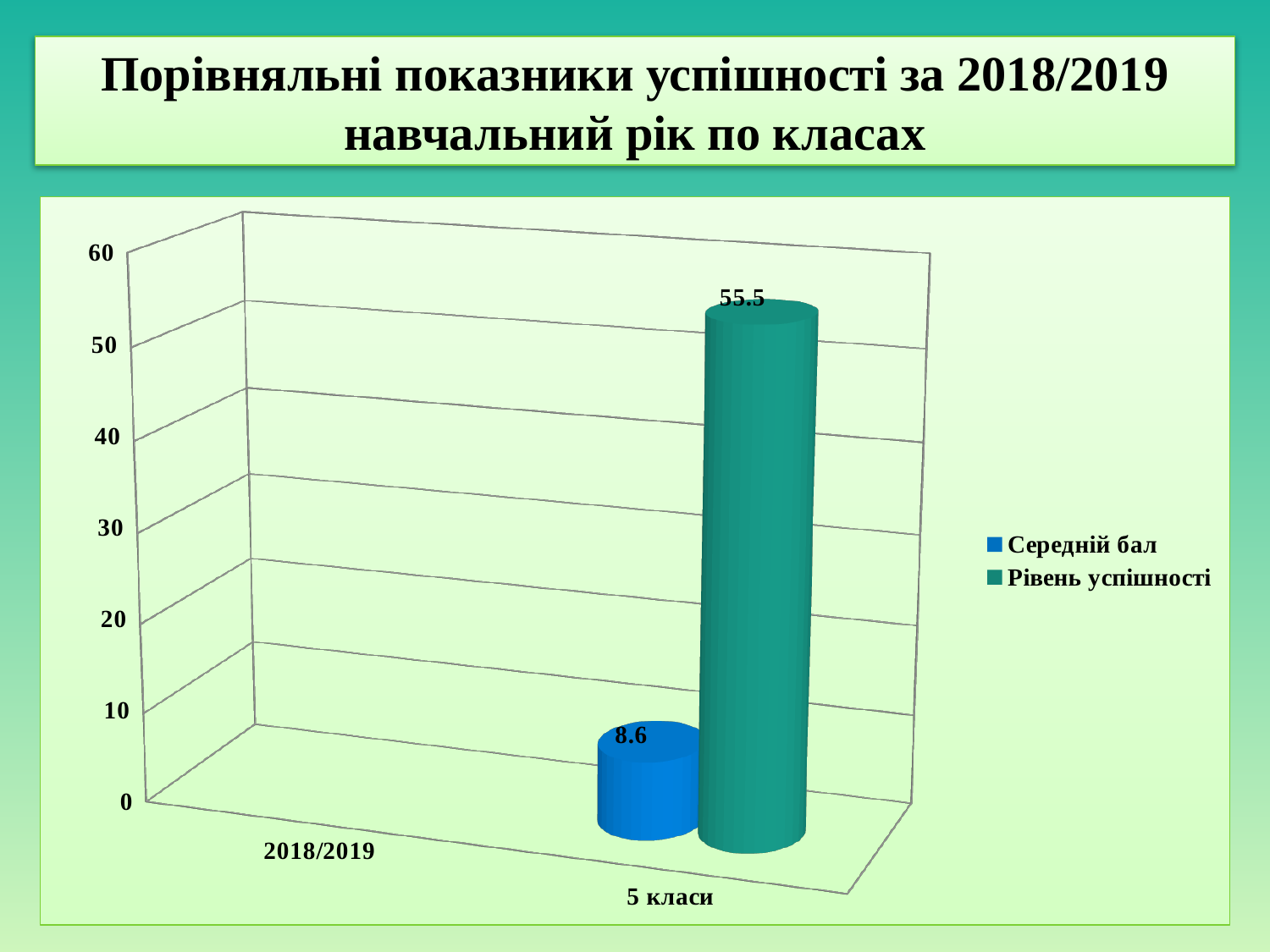
How many series does the legend list? 2 Which series has the higher value for 5 класи, Середній бал or Рівень успішності? Рівень успішності Is the value of Рівень успішності for 5 класи greater or less than 50? greater What is the value of Середній бал for 5 класи? 8.6 What kind of chart is shown on the slide? bar chart What is the difference between Рівень успішності and Середній бал for 5 класи? 46.9 What is the highest value shown on the vertical axis of the chart? 60 How many categories are shown on the x axis of the chart? 2 What is the value of Рівень успішності for 5 класи? 55.5 Is the value of Середній бал for 5 класи greater or less than 10? less Which series is shown in blue in the legend? Середній бал